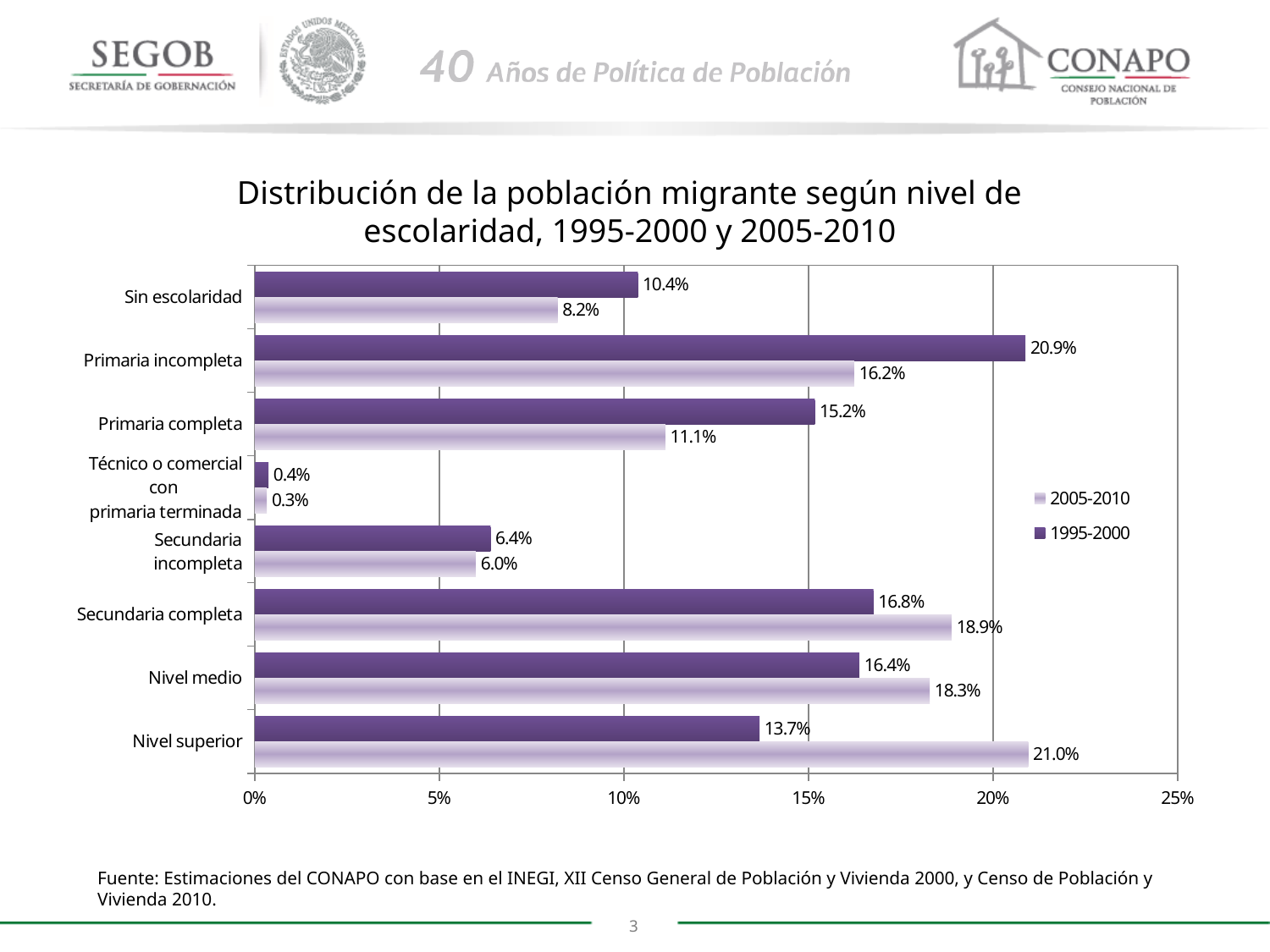
What is the value for Sin escolaridad in the 2005-2010 series? 8.2% Is the 1995-2000 value for Primaria completa greater or less than 10%? greater How many education-level categories are shown on the chart? 8 What kind of chart is shown on the slide? Bar chart What is the title of the chart? Distribución de la población migrante según nivel de escolaridad, 1995-2000 y 2005-2010 Which category has the highest value in the 1995-2000 series? Primaria incompleta What is the value for Primaria incompleta in the 1995-2000 series? 20.9% What is the value for Nivel superior in the 2005-2010 series? 21.0% Which category has the lowest value in the 2005-2010 series? Técnico o comercial con primaria terminada How many series does the legend list? 2 What is the difference between the 2005-2010 and 1995-2000 values for Nivel superior? 7.3% For Secundaria completa, which series has the larger value, 1995-2000 or 2005-2010? 2005-2010